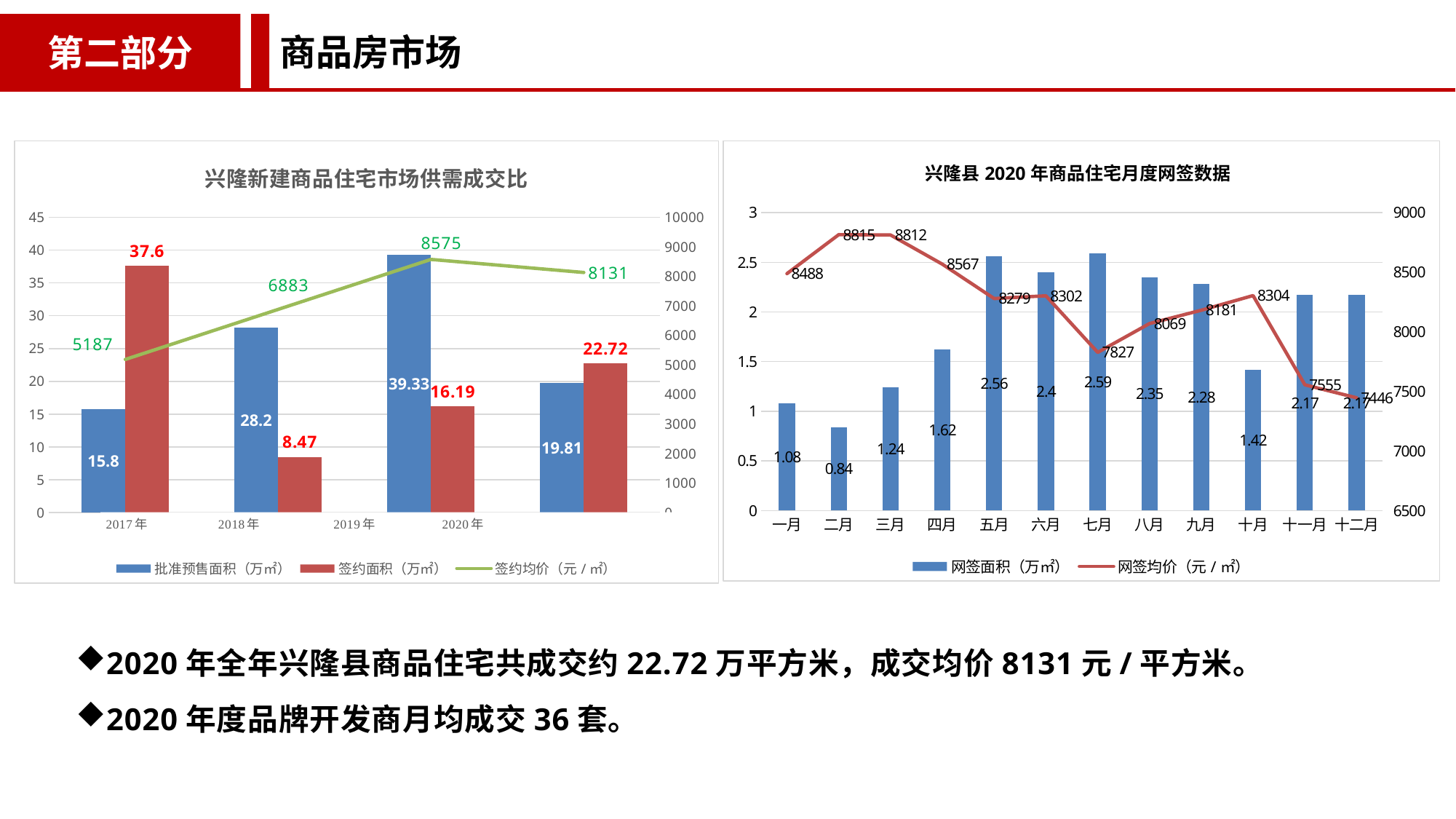
In the chart titled 兴隆县 2020 年商品住宅月度网签数据, which month has the lowest 网签面积? 二月 In the chart titled 兴隆县 2020 年商品住宅月度网签数据, how many months are shown on the x axis? 12 In the chart titled 兴隆新建商品住宅市场供需成交比, what is the 批准预售面积 value for 2019年? 39.33 In the chart titled 兴隆新建商品住宅市场供需成交比, how many series does the legend list? 3 In the chart titled 兴隆县 2020 年商品住宅月度网签数据, what is the 网签面积 value for 七月? 2.59 In the chart titled 兴隆县 2020 年商品住宅月度网签数据, which month has the highest 网签均价? 二月 In the chart titled 兴隆新建商品住宅市场供需成交比, what is the 签约均价 value for 2017年? 5187 In the chart titled 兴隆新建商品住宅市场供需成交比, which year has the highest 签约面积? 2017年 In the chart titled 兴隆县 2020 年商品住宅月度网签数据, what is the difference between the 网签均价 values for 一月 and 十二月? 1042 In the chart titled 兴隆新建商品住宅市场供需成交比, what is the difference between the 批准预售面积 and 签约面积 values for 2020年? 2.91 In the chart titled 兴隆县 2020 年商品住宅月度网签数据, what is the 网签均价 value for 十一月? 7555 In the chart titled 兴隆县 2020 年商品住宅月度网签数据, is the 网签面积 larger for 五月 or 十月? 五月